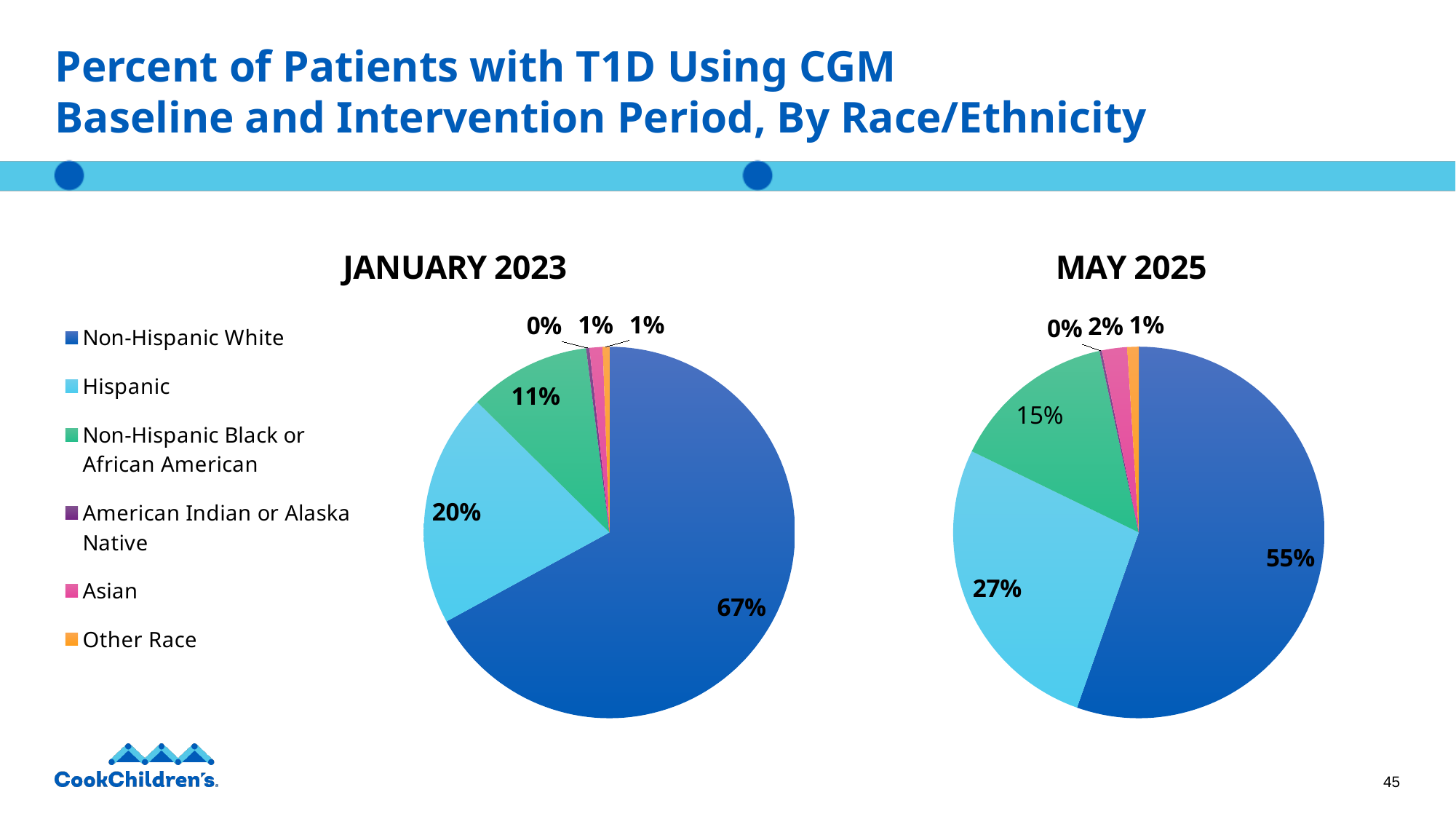
How many categories does the legend list for the pie charts? 6 In the May 2025 pie chart, what share is labelled for Hispanic? 27% What is the difference between the Non-Hispanic White share in January 2023 and in May 2025? 12 percentage points In the January 2023 pie chart, what share is labelled for Hispanic? 20% In the May 2025 pie chart, what share is labelled for Asian? 2% In the May 2025 pie chart, which category is labelled 0%? American Indian or Alaska Native In the January 2023 pie chart, which category has the largest slice? Non-Hispanic White What type of chart is used for the January 2023 and May 2025 data? Pie chart Which legend category is shown in orange? Other Race Is the Hispanic share larger in the January 2023 chart or the May 2025 chart? May 2025